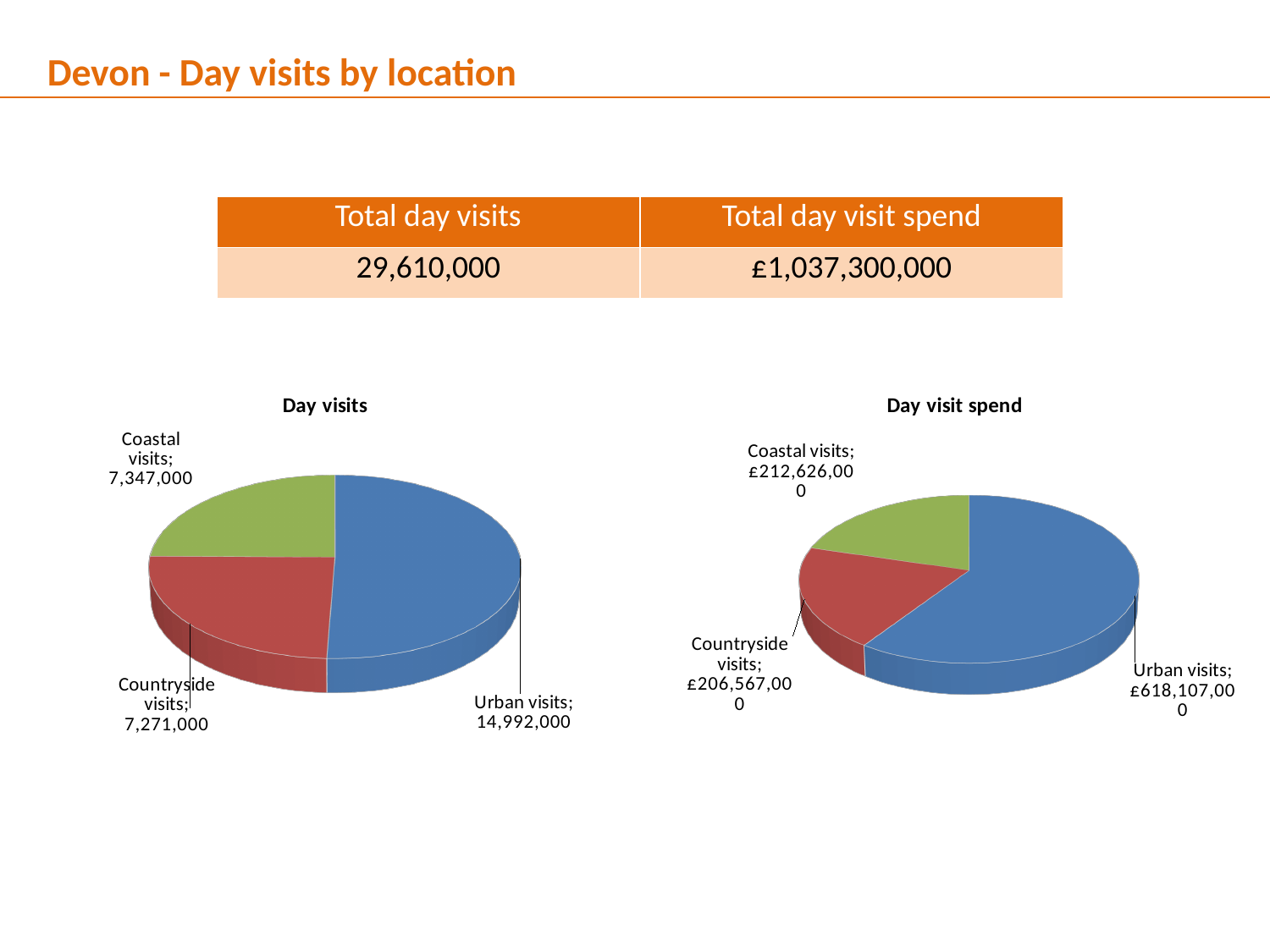
In the Day visit spend chart, what is the value for Countryside visits? £206,567,000 In the Day visits chart, what is the value for Coastal visits? 7,347,000 How many slices does the Day visits chart have? 3 In the Day visit spend chart, which category has the smallest value? Countryside visits In the Day visits chart, what is the difference between Coastal visits and Countryside visits? 76,000 In the Day visit spend chart, what is the difference between Urban visits and Coastal visits? £405,481,000 In the Day visit spend chart, what is the value for Urban visits? £618,107,000 In the Day visits chart, which category has the largest slice? Urban visits In the Day visit spend chart, which is larger: Coastal visits or Countryside visits? Coastal visits In the Day visits chart, which category has the smallest value? Countryside visits What kind of chart is the Day visit spend chart? Pie chart In the Day visits chart, what is the value for Urban visits? 14,992,000